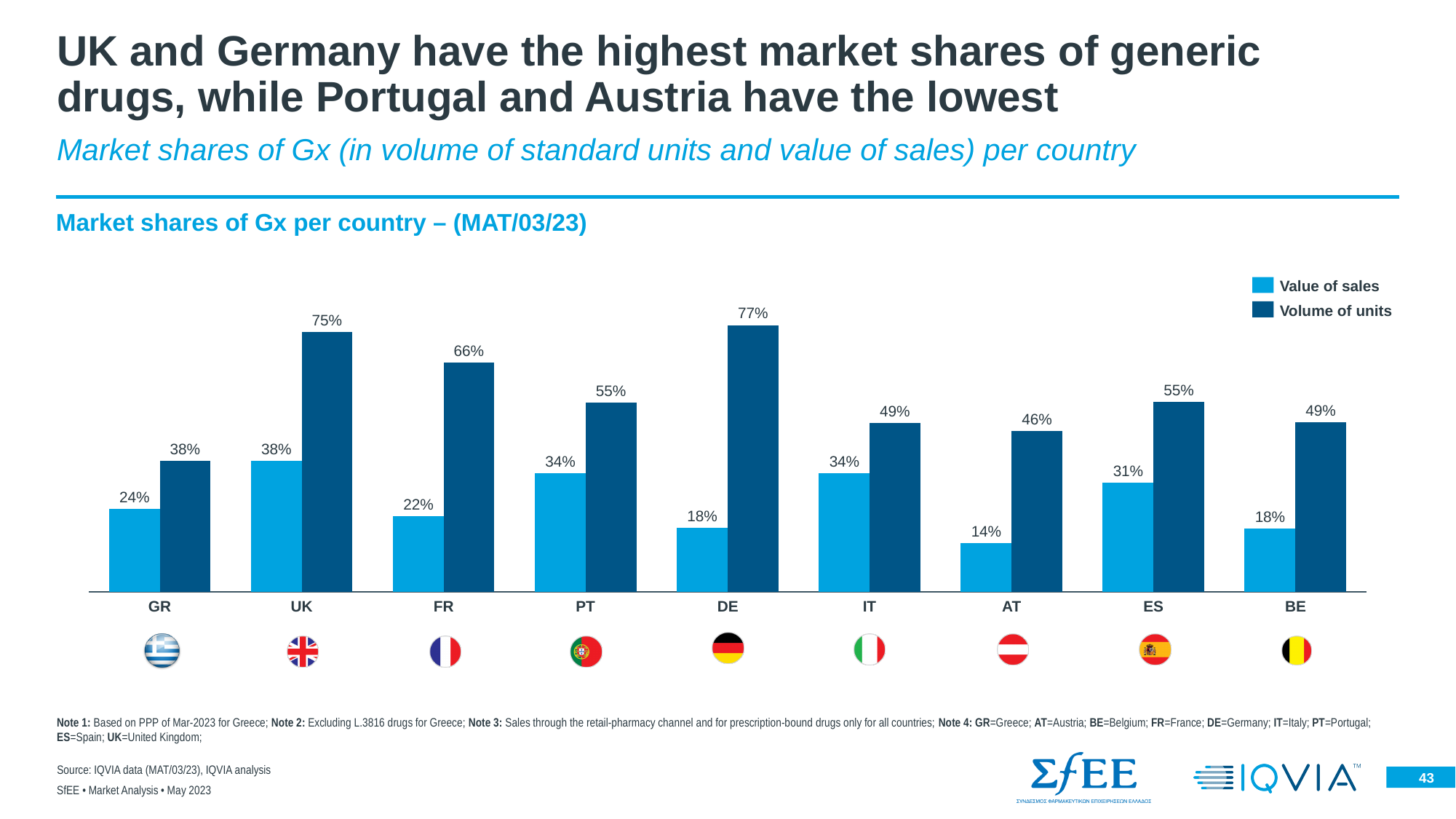
What is the Value of sales market share of Gx for AT? 14% What kind of chart is shown on the slide? Bar chart What is the Value of sales market share of Gx for GR? 24% How many countries are shown on the x axis? 9 Which is larger, the Volume of units share for FR or for PT? FR What is the Volume of units market share of Gx for DE? 77% Which country has the lowest Value of sales market share? AT Which country has the highest Volume of units market share? DE What is the difference between the Volume of units and Value of sales shares for UK? 37% What is the difference in Value of sales share between ES and BE? 13% Which series is shown in dark blue in the legend? Volume of units How many series does the legend list? 2